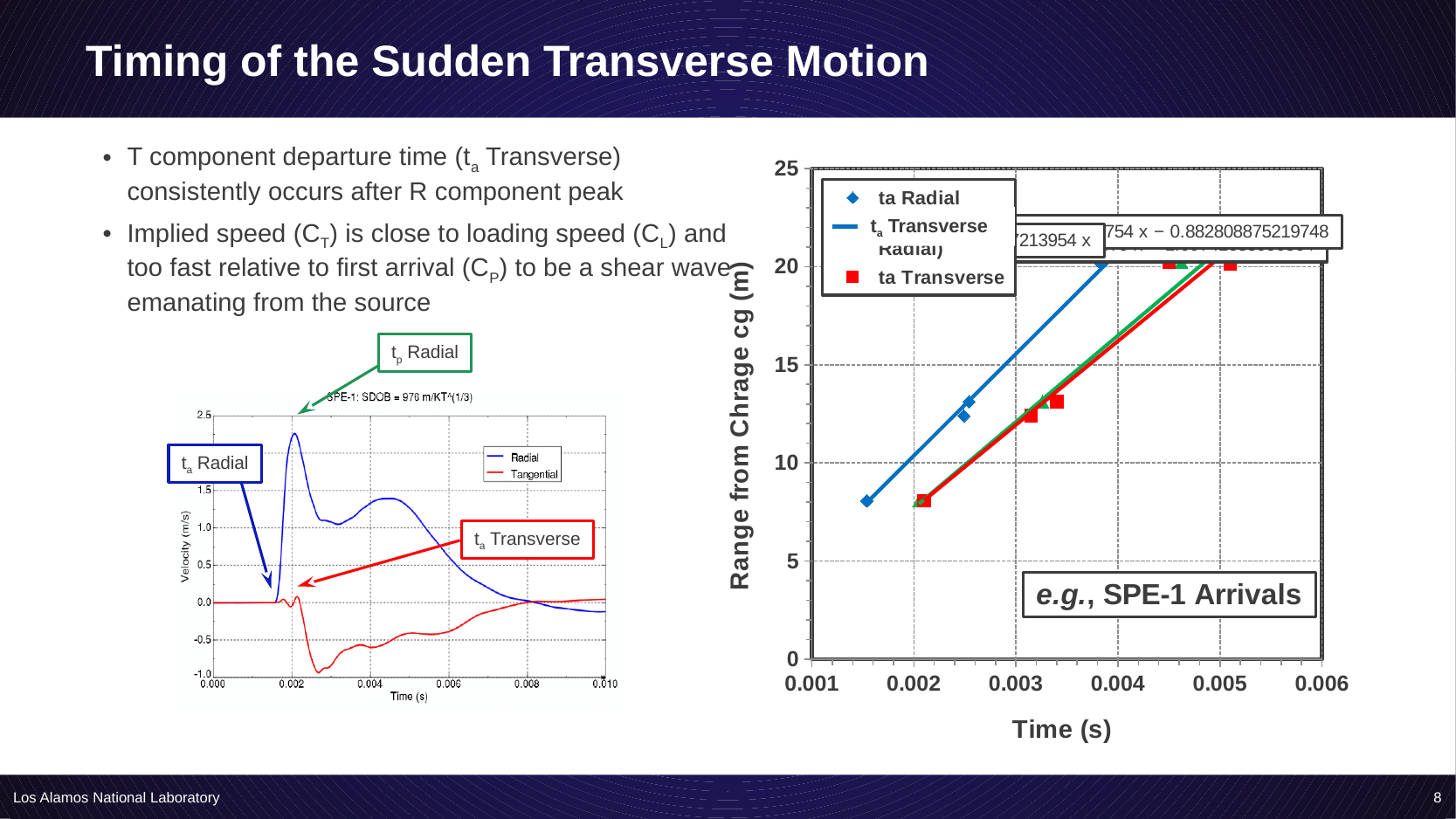
What kind of chart is the right-hand chart titled 'e.g., SPE-1 Arrivals'? scatter chart In the right-hand chart (SPE-1 Arrivals), is the largest range value for the ta Transverse points greater or less than 15? greater In the left-hand velocity chart, which series reaches the higher peak velocity, Radial or Tangential? Radial In the right-hand chart (SPE-1 Arrivals), do the ta Transverse range values rise or fall as time increases? rise In the left-hand velocity chart, is the peak of the Radial series reached at a time greater or less than 0.004? less In the right-hand chart (SPE-1 Arrivals), what is the y-axis title? Range from Chrage cg (m) In the right-hand chart (SPE-1 Arrivals), at the lowest range (about 8 m), which arrives at an earlier time, ta Radial or ta Transverse? ta Radial In the right-hand chart (SPE-1 Arrivals), what is the x-axis title? Time (s) In the right-hand chart (SPE-1 Arrivals), is the time of the earliest ta Radial point greater or less than 0.002? less How many series does the legend of the left-hand velocity chart list? 2